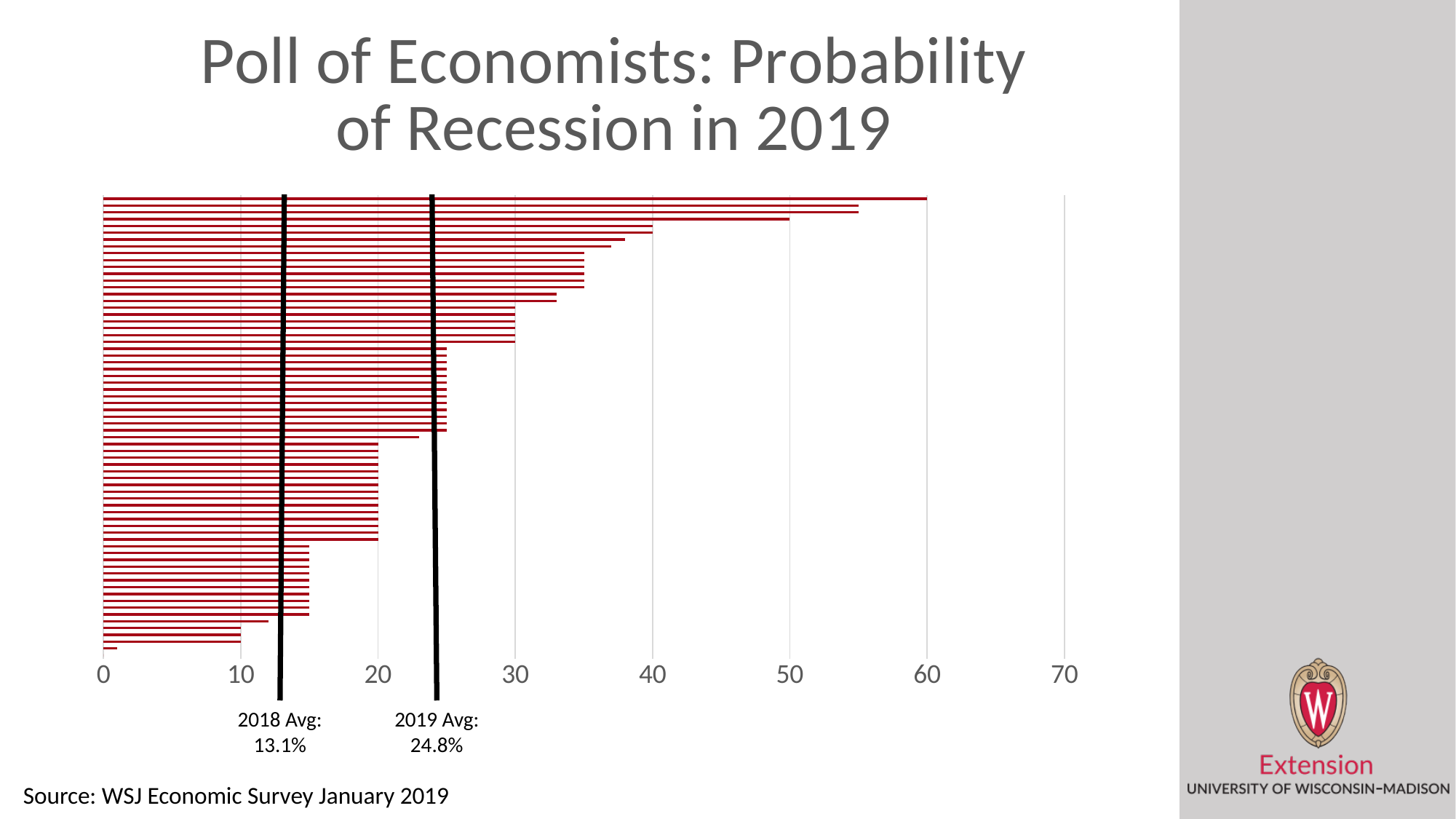
Do the bar values rise or fall going from the top of the chart to the bottom? fall What source is cited for the chart data? WSJ Economic Survey January 2019 What is the 2019 average probability of recession marked on the chart? 24.8% Which is higher, the 2018 average or the 2019 average? 2019 Avg What is the highest probability of recession given by any economist in the poll? 60 Is the shortest bar's value greater or less than 10? less What is the title of the chart? Poll of Economists: Probability of Recession in 2019 What type of chart is shown on the slide? bar chart Is the longest bar's value greater or less than 50? greater By how many percentage points does the 2019 average exceed the 2018 average? 11.7 percentage points What is the 2018 average probability of recession marked on the chart? 13.1%